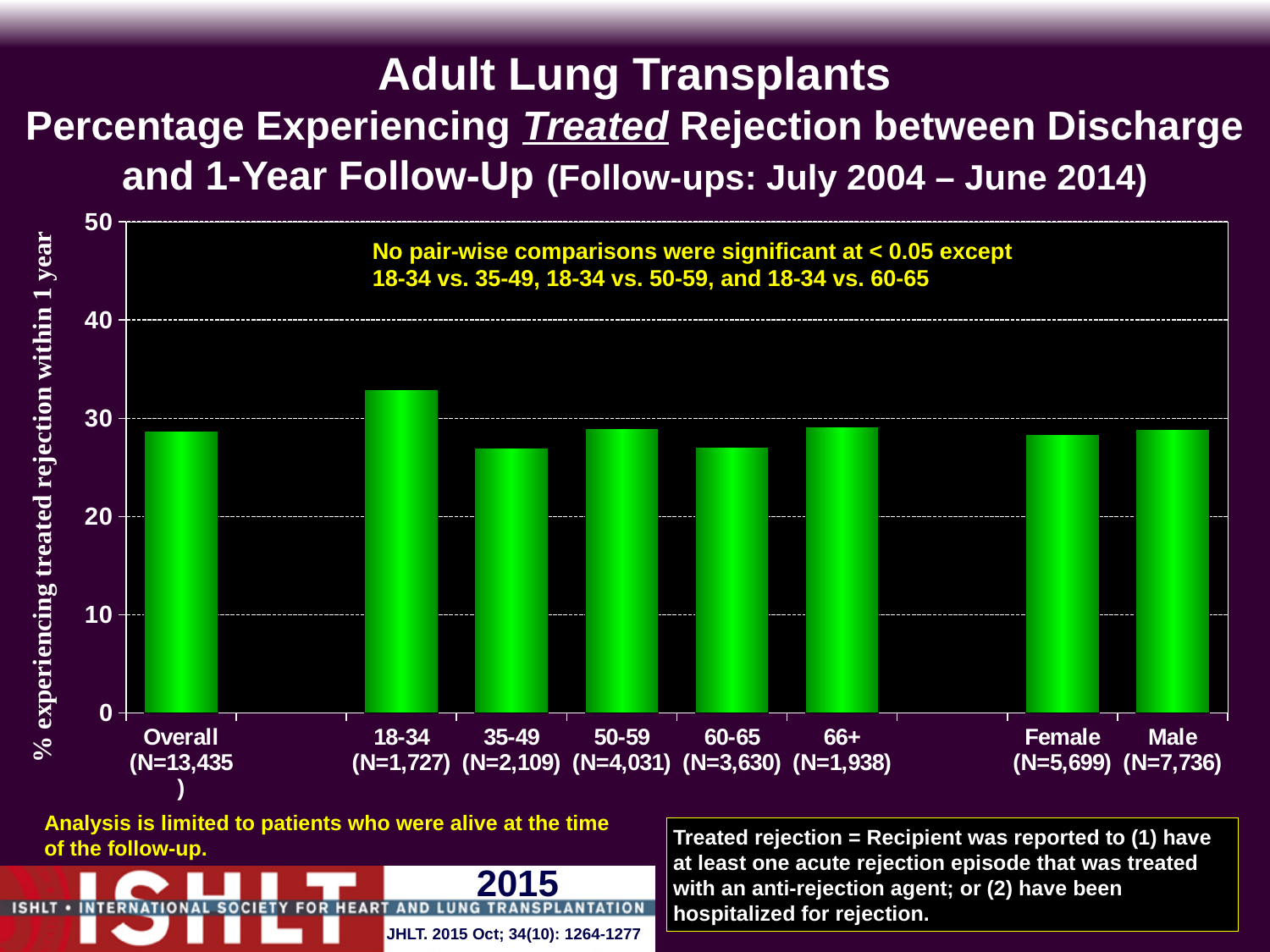
Is the value for the 18-34 age group greater or less than 30? greater Which has a higher percentage experiencing treated rejection, the 18-34 group or the 35-49 group? 18-34 Is the value for Female greater or less than 30? less Which has a higher percentage experiencing treated rejection, the 18-34 group or the 60-65 group? 18-34 Which category has the highest percentage experiencing treated rejection within 1 year? 18-34 Is the value for the 60-65 age group greater or less than 20? greater What kind of chart is shown on the slide? bar chart What is the sample size (N) shown for the Overall category? N=13,435 How many bars (categories) are plotted in the chart? 8 What is the label on the y-axis of the chart? % experiencing treated rejection within 1 year